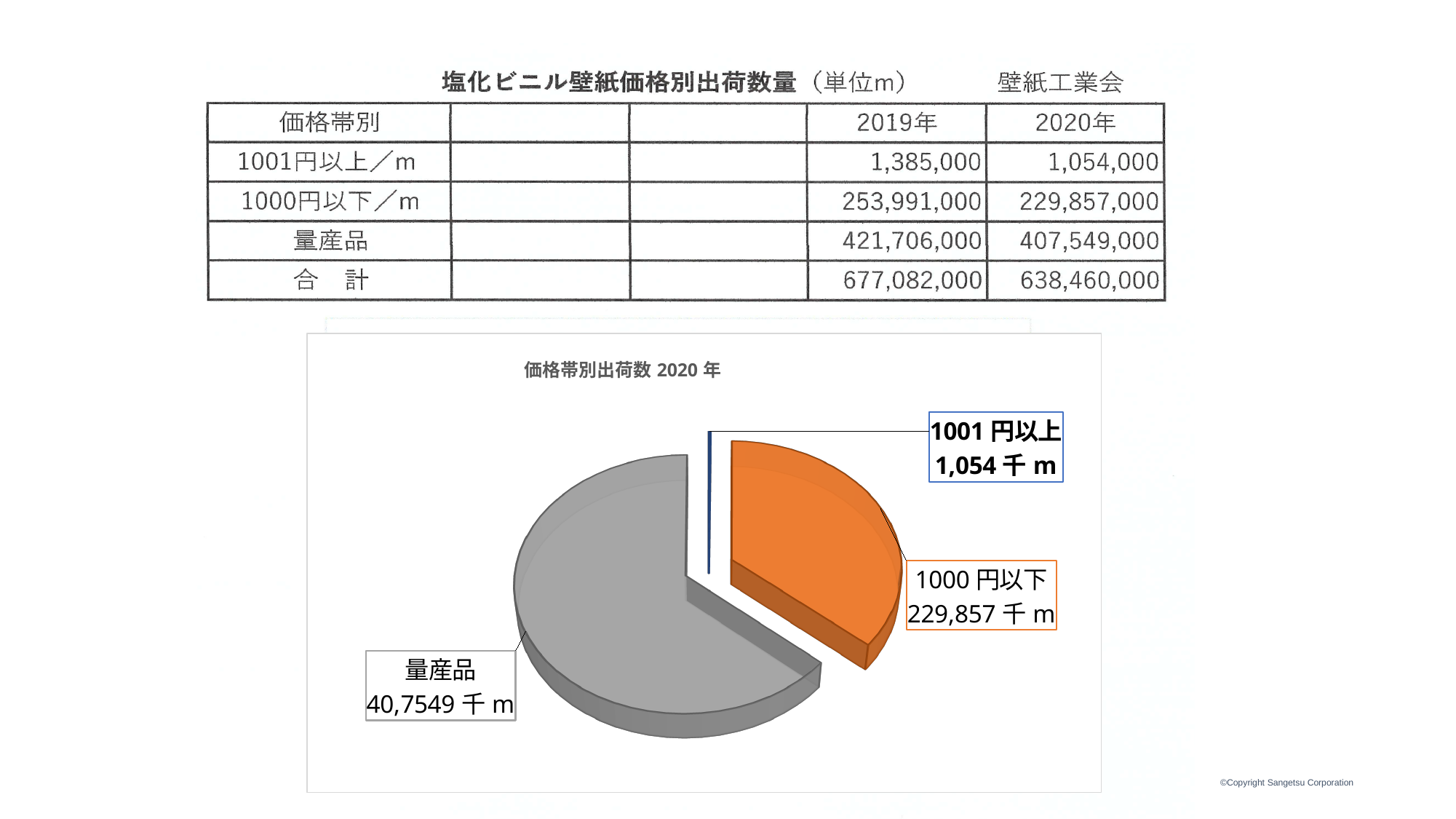
In the pie chart, what is the difference between the 1000 円以下 value and the 1001 円以上 value? 228,803 千 m Which category has the smallest slice in the pie chart? 1001 円以上 How many slices does the pie chart have? 3 What kind of chart is shown on the slide? pie chart In the pie chart, which is larger: 1000 円以下 or 1001 円以上? 1000 円以下 What value is labelled for the 1001 円以上 slice in the pie chart? 1,054 千 m What colour is the 1000 円以下 slice in the pie chart? orange What value is labelled for the 1000 円以下 slice in the pie chart? 229,857 千 m Which category has the largest slice in the pie chart? 量産品 What is the title of the pie chart? 価格帯別出荷数 2020 年